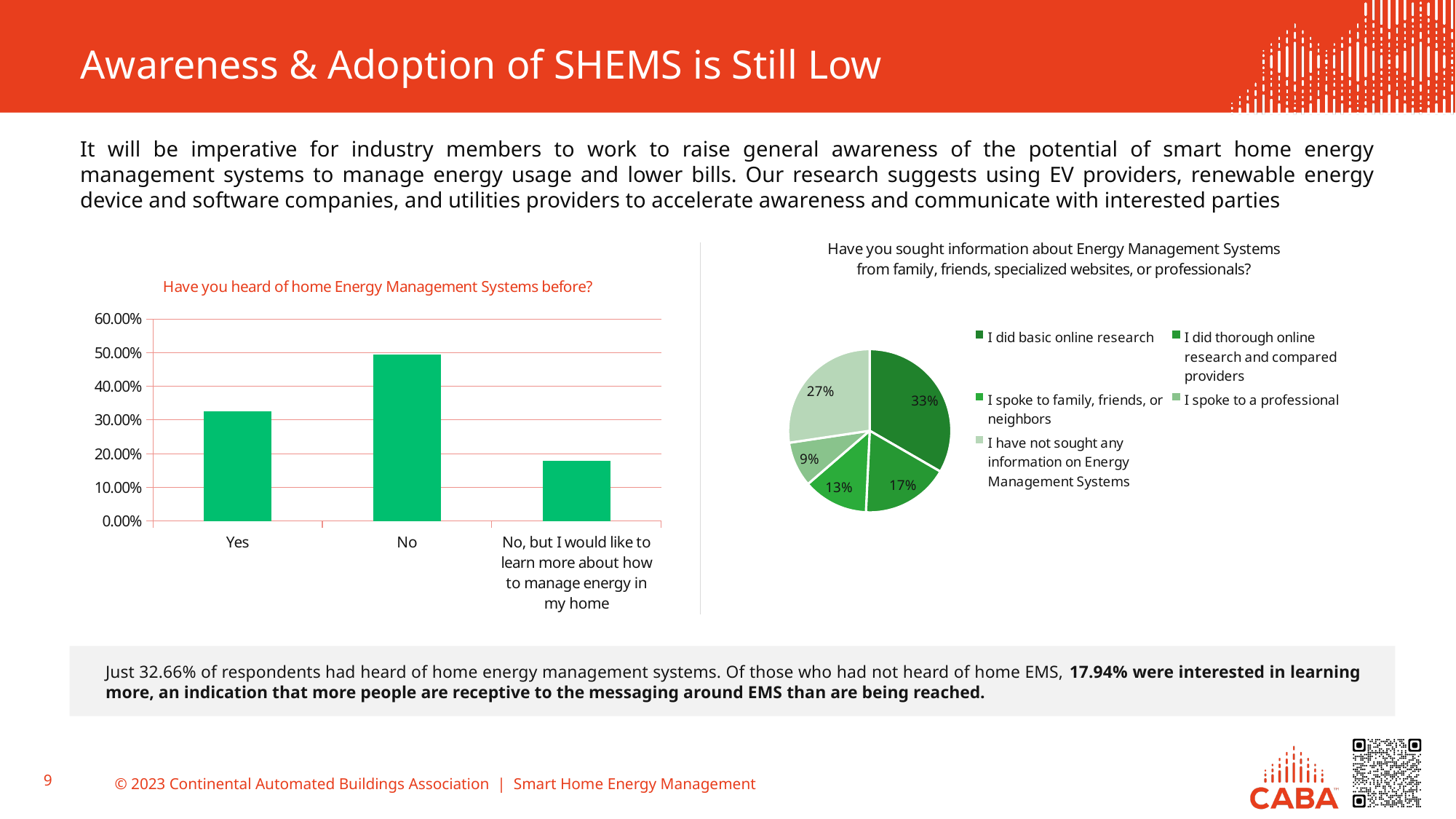
In the right pie chart, what share of respondents said 'I spoke to a professional'? 9% In the left bar chart, which category has the lowest value? No, but I would like to learn more about how to manage energy in my home What kind of chart is the left chart titled 'Have you heard of home Energy Management Systems before?'? bar chart How many entries does the legend of the right pie chart list? 5 In the left bar chart, is the value for 'No, but I would like to learn more about how to manage energy in my home' greater or less than 20.00%? less In the left bar chart, which category has the highest value? No In the right pie chart, what share of respondents said 'I did basic online research'? 33% In the right pie chart, what is the difference between the share for 'I have not sought any information on Energy Management Systems' and the share for 'I did thorough online research and compared providers'? 10% In the left bar chart, is the value for 'Yes' greater or less than 30.00%? greater What kind of chart is the right chart titled 'Have you sought information about Energy Management Systems from family, friends, specialized websites, or professionals?'? pie chart In the left bar chart, how many categories are shown on the x axis? 3